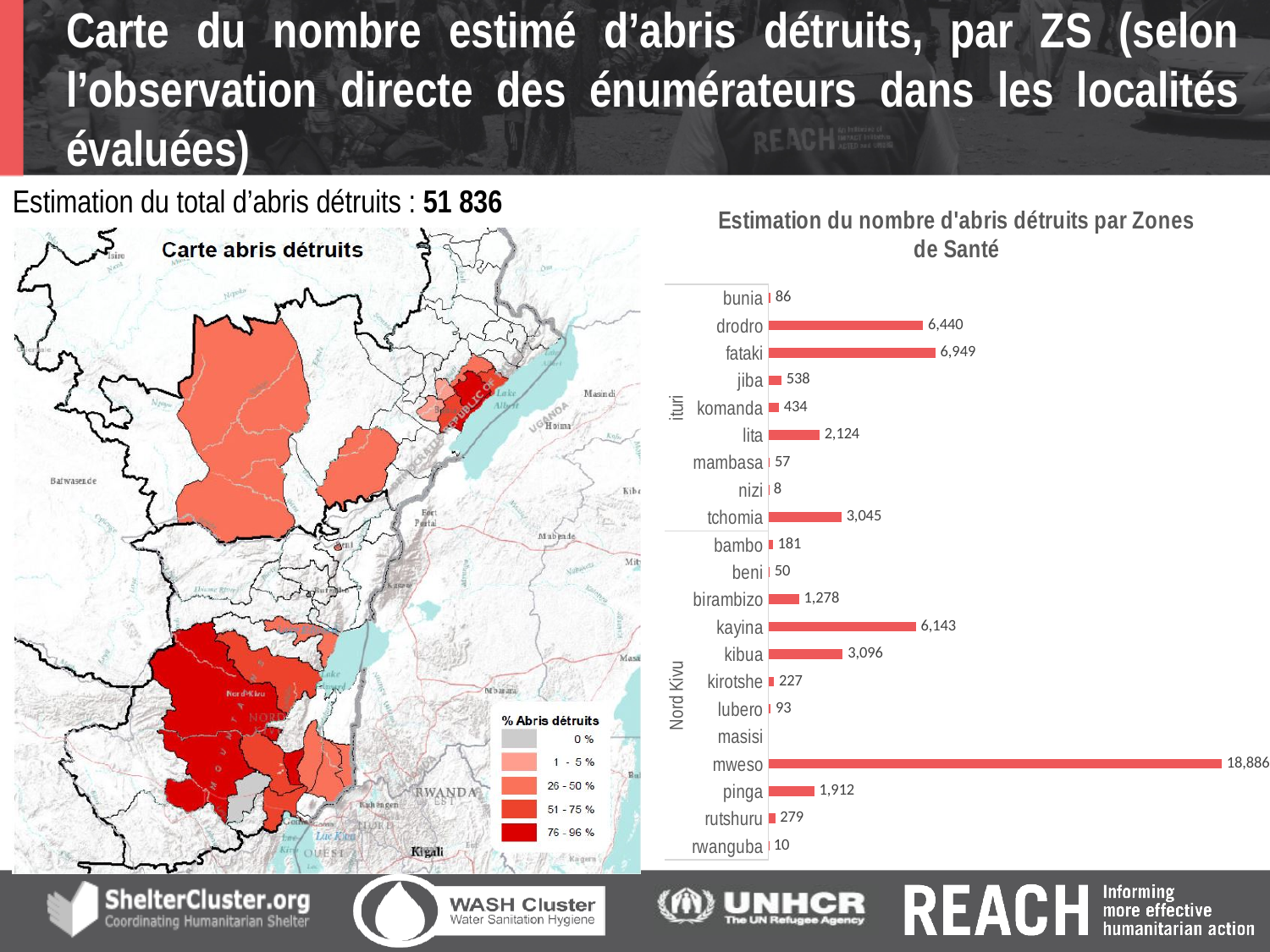
How many zones de santé are listed on the vertical axis of the bar chart on the right? 21 In the bar chart on the right, which labelled zone has the lowest value? nizi In the bar chart on the right, what is the value for fataki? 6,949 In the bar chart on the right, what is the value for kibua? 3,096 What is the estimated total number of destroyed shelters stated on the slide? 51 836 In the bar chart 'Estimation du nombre d'abris détruits par Zones de Santé', what is the value for mweso? 18,886 In the bar chart on the right, which is larger, the value for kayina or the value for tchomia? kayina What type of chart is shown on the right side of the slide? bar chart In the bar chart on the right, what is the difference between the values for fataki and drodro? 509 In the bar chart on the right, what is the difference between the values for mweso and kayina? 12,743 In the bar chart on the right, which zone de santé has the highest estimated number of destroyed shelters? mweso In the bar chart on the right, which two provinces group the zones de santé on the vertical axis? Ituri and Nord Kivu